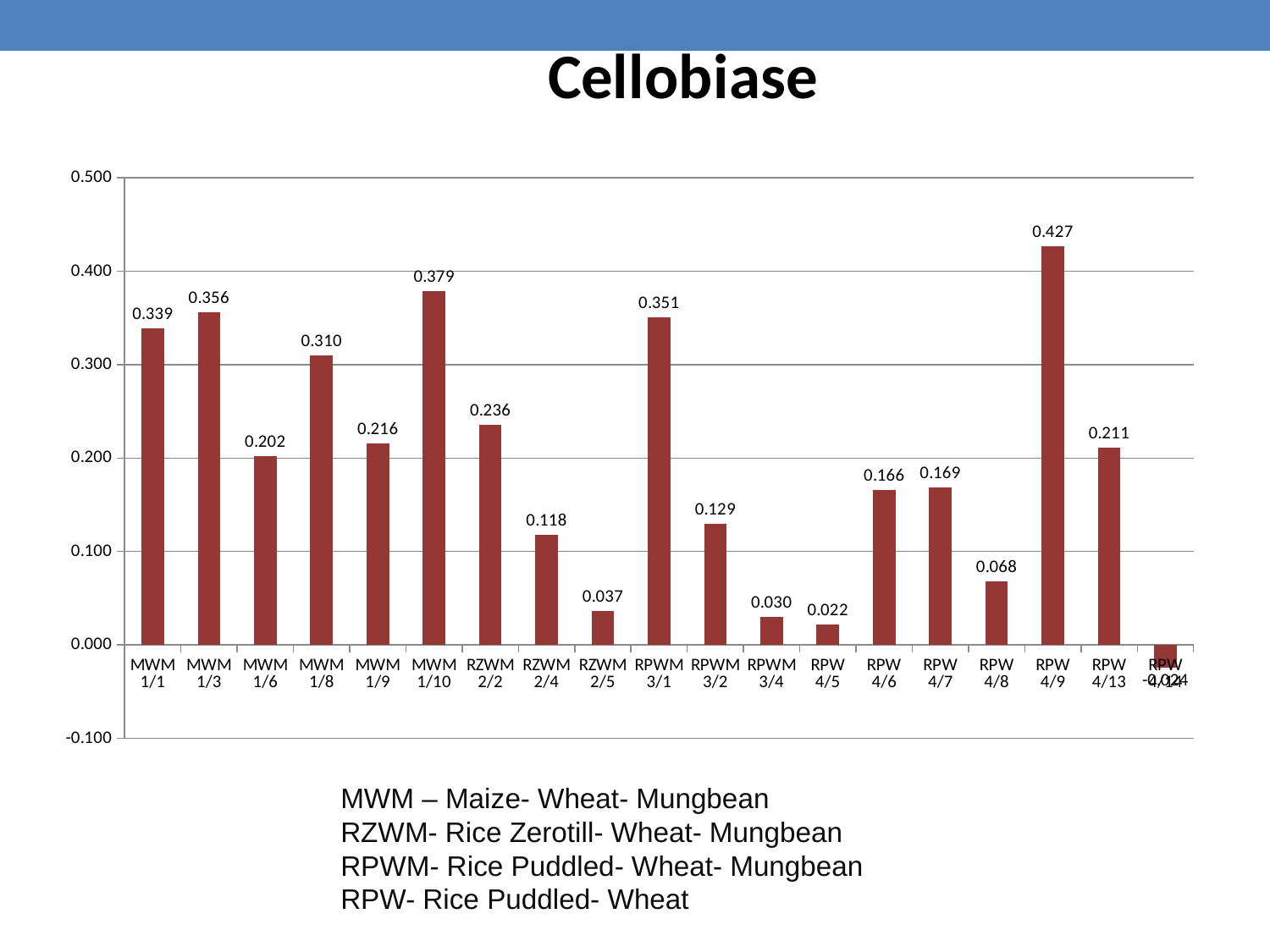
What is the difference between the Cellobiase values for RPW 4/9 and MWM 1/10? 0.048 Which category has the highest Cellobiase value? RPW 4/9 What is the difference between the Cellobiase values for RPW 4/7 and RPW 4/6? 0.003 What kind of chart is shown on the slide? bar chart What is the Cellobiase value for RZWM 2/5? 0.037 What is the title of the chart? Cellobiase What is the Cellobiase value for RPW 4/8? 0.068 What is the Cellobiase value for RPWM 3/1? 0.351 Which has a larger Cellobiase value, RPWM 3/2 or RPW 4/13? RPW 4/13 Is the Cellobiase value for MWM 1/3 greater or less than 0.300? greater What is the Cellobiase value for MWM 1/10? 0.379 Which has a larger Cellobiase value, MWM 1/8 or RZWM 2/2? MWM 1/8